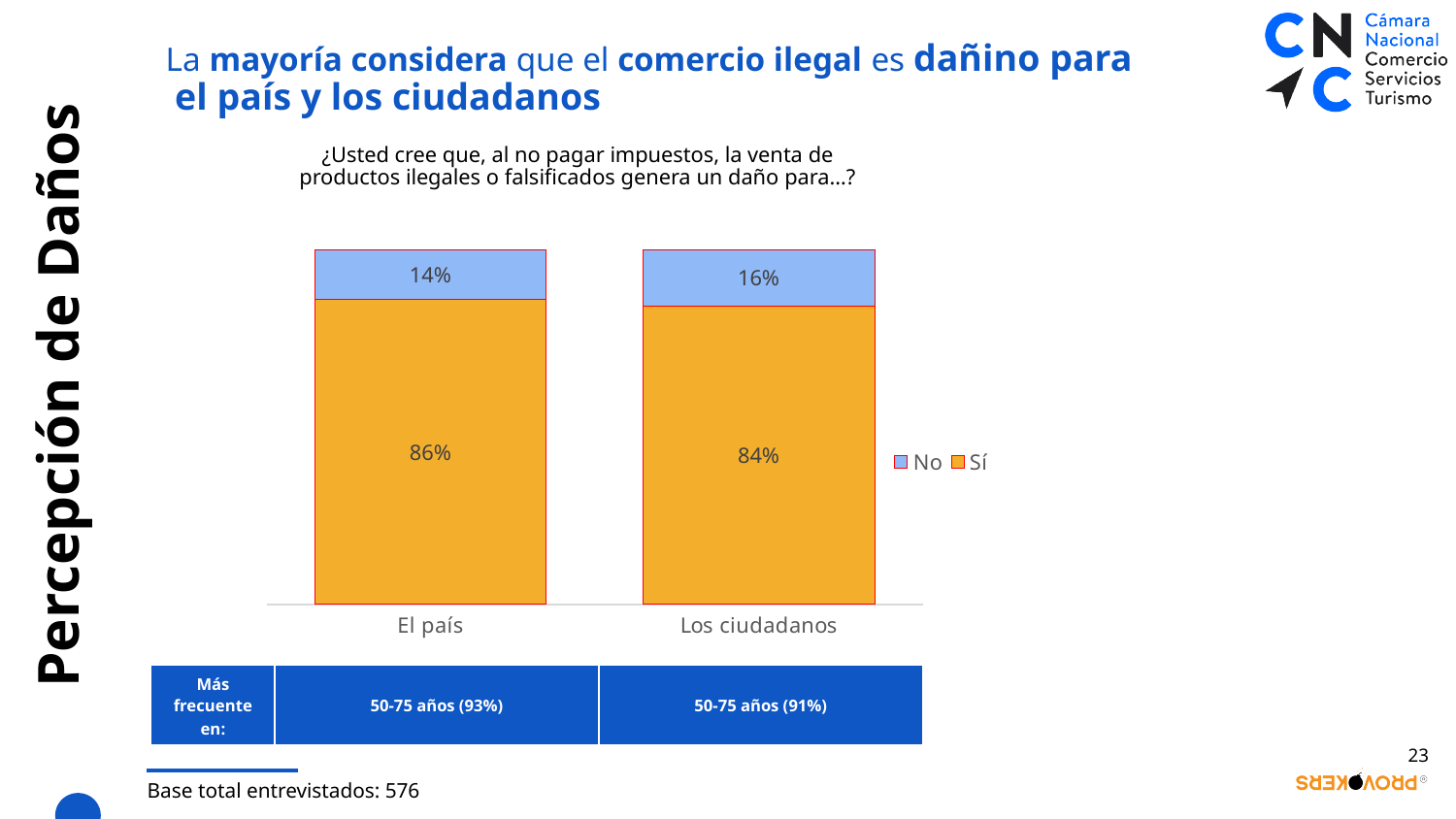
What percentage of respondents answered "No" for "El país"? 14% What percentage of respondents answered "Sí" for "Los ciudadanos"? 84% How many categories are shown on the x axis of the chart? 2 What percentage of respondents answered "No" for "Los ciudadanos"? 16% What is the difference between the "Sí" values for "El país" and "Los ciudadanos"? 2% Which series is shown in orange in the chart? Sí What percentage of respondents answered "Sí" for "El país"? 86% Which category has the lowest "No" value? El país Which category has the higher "Sí" value, "El país" or "Los ciudadanos"? El país What is the total of the stacked bar for "El país"? 100% What kind of chart is shown on the slide? Stacked bar chart How many series does the legend list? 2